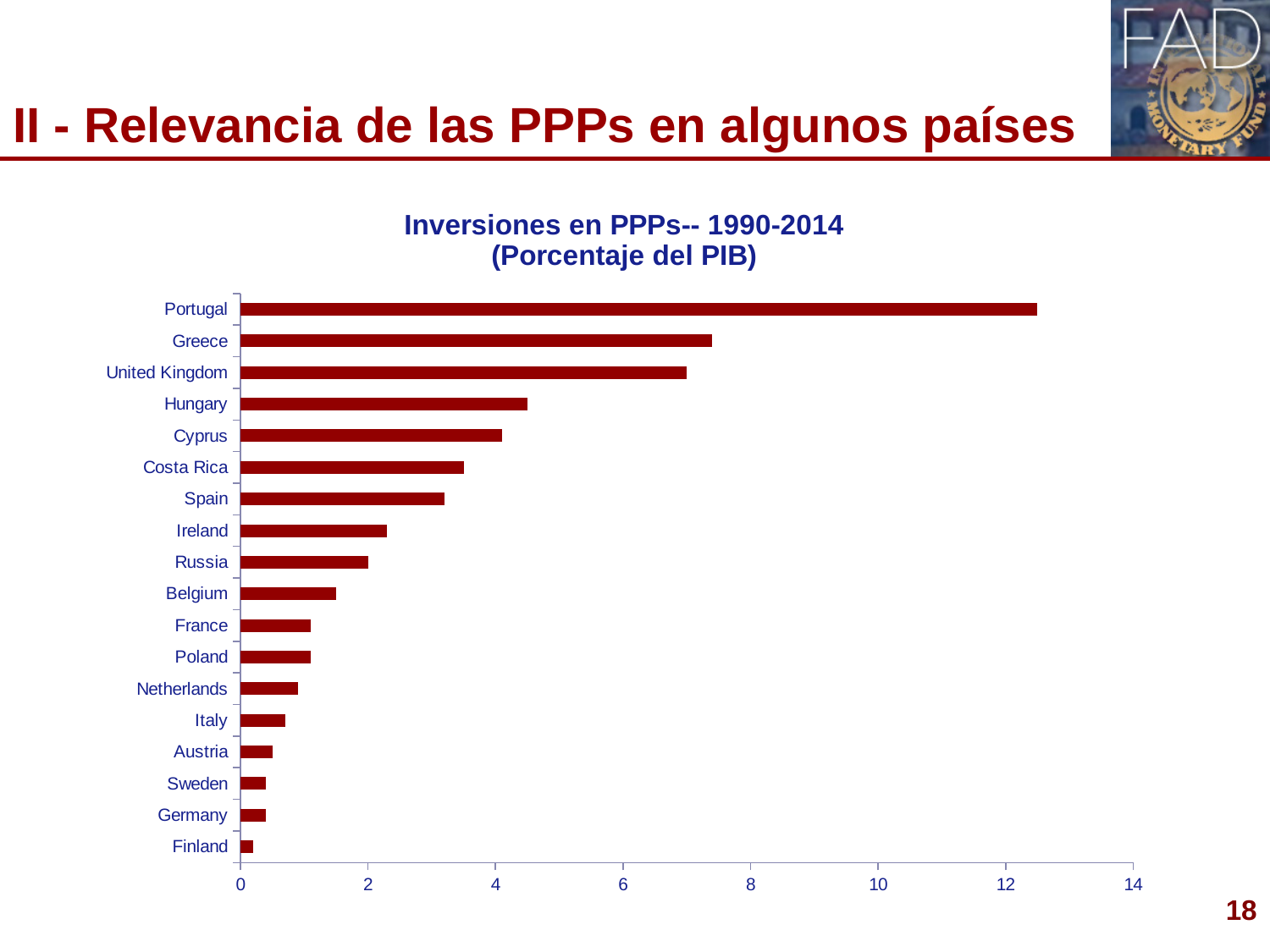
How many countries are shown in the chart? 18 What is the title of the chart? Inversiones en PPPs-- 1990-2014 (Porcentaje del PIB) Is the value for Hungary greater or less than 4? greater Is the value for Belgium greater or less than 2? less Is the value for Costa Rica greater or less than 4? less What type of chart is shown on the slide? Bar chart Which has a larger value, Portugal or Greece? Portugal Which country has the highest PPP investment as a percentage of GDP? Portugal Which country has the lowest PPP investment as a percentage of GDP? Finland Which has a larger value, Hungary or Spain? Hungary